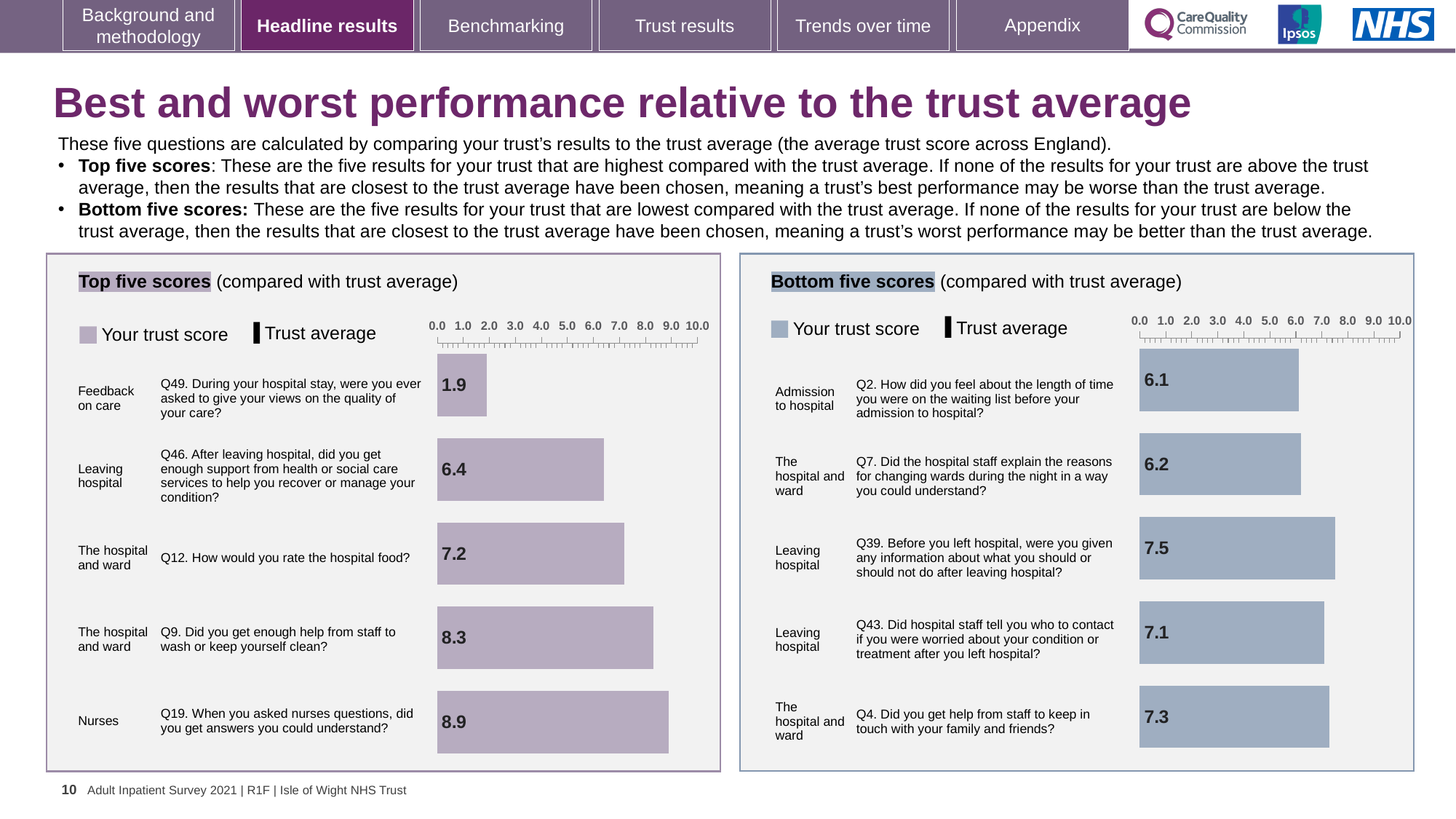
In the Bottom five scores chart, which question has the lowest trust score? Q2. How did you feel about the length of time you were on the waiting list before your admission to hospital? In the Bottom five scores chart, what is the trust score for Q39 (information about what you should or should not do after leaving hospital)? 7.5 In the Bottom five scores chart, what is the difference between the scores for Q39 and Q2? 1.4 In the Top five scores chart, what is the difference between the scores for Q19 and Q49? 7.0 In the Top five scores chart, what is the trust score for Q49 (asked to give your views on the quality of your care)? 1.9 What type of chart is the Top five scores chart? Bar chart In the Top five scores chart, what is the trust score for Q12 (How would you rate the hospital food?)? 7.2 How many questions are shown in the Bottom five scores chart? 5 How many entries does the legend of the Bottom five scores chart list? 2 In the Top five scores chart, which has the larger score: Q46 or Q9? Q9 In the Top five scores chart, which question has the highest trust score? Q19. When you asked nurses questions, did you get answers you could understand? In the Bottom five scores chart, what is the trust score for Q4 (help from staff to keep in touch with family and friends)? 7.3